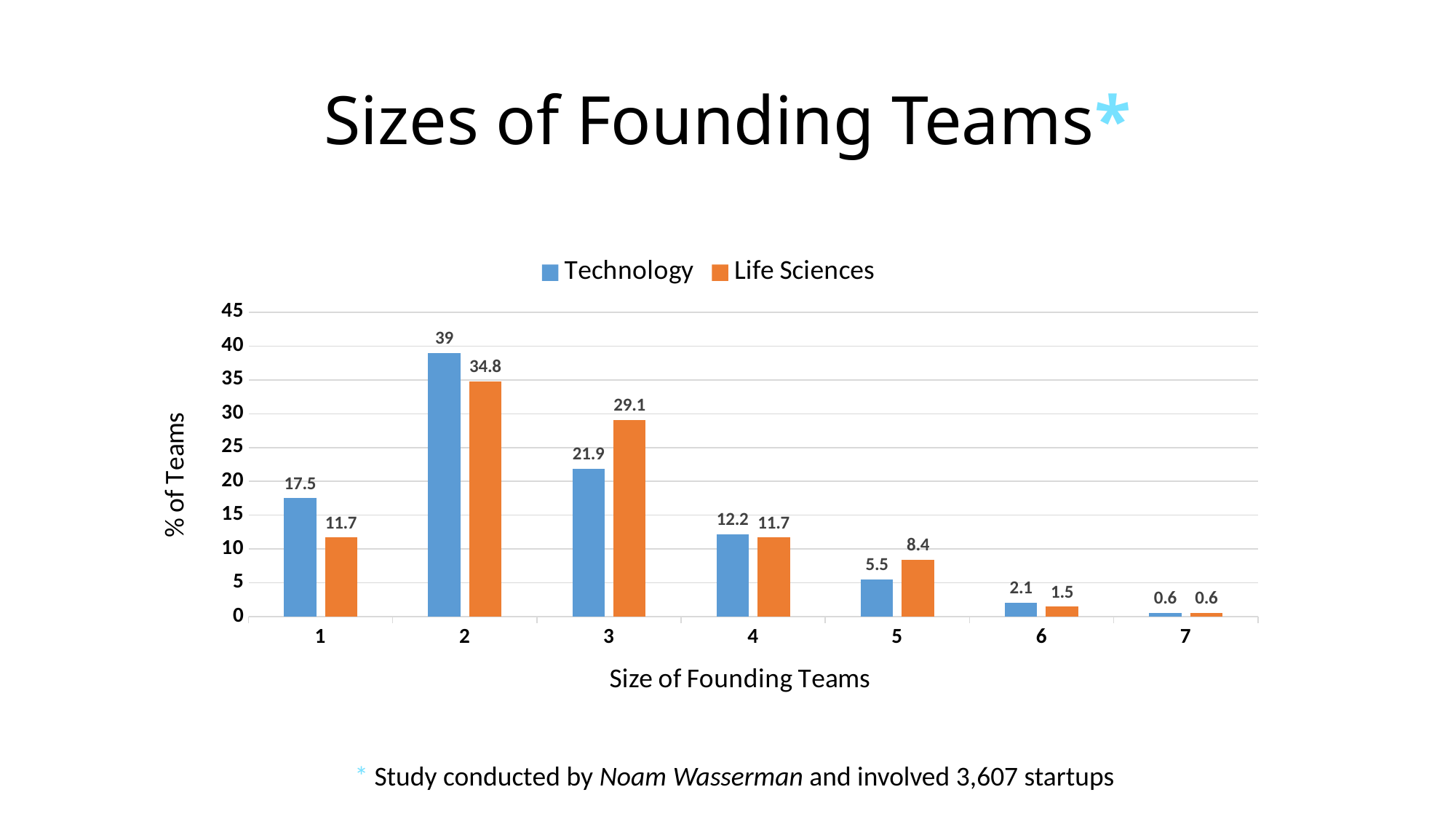
What is the label of the y axis? % of Teams What is the difference between the Technology and Life Sciences values for founding team size 1? 5.8 Which founding team size has the lowest Technology value? 7 What is the Technology value for founding team size 5? 5.5 Is the Technology value for founding team size 2 greater or less than 35? greater What is the Technology value for founding team size 2? 39 How many founding team size categories are shown on the x axis? 7 What is the Life Sciences value for founding team size 3? 29.1 What kind of chart is shown on the slide? Bar chart For founding team size 3, which series has the larger value, Technology or Life Sciences? Life Sciences Which founding team size has the highest Life Sciences value? 2 How many series does the legend list? 2